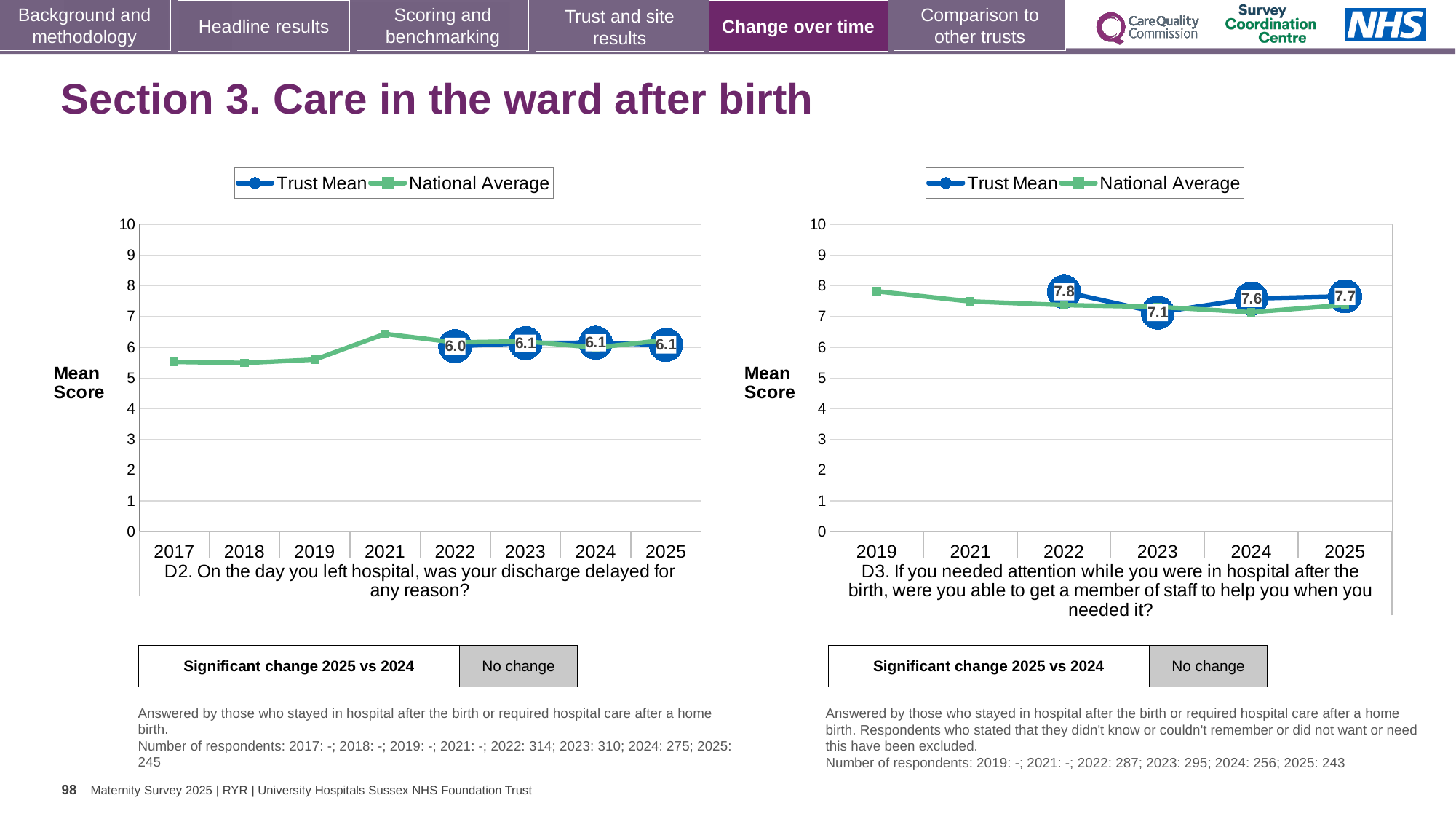
How many series does the legend of the D3 chart on the right list? 2 In the D3 chart on the right, which year has the lowest Trust Mean score? 2023 In the D2 chart on the left, what is the Trust Mean score for 2022? 6.0 In the D2 chart on the left, is the National Average for 2017 greater or less than 6? less What kind of chart is the D2 chart on the left? Line chart How many years are shown on the x axis of the D2 chart on the left? 8 In the D3 chart on the right, is the National Average for 2019 greater or less than 7? greater In the D3 chart on the right, which is larger: the Trust Mean for 2024 or the Trust Mean for 2025? 2025 In the D3 chart on the right, what is the difference between the Trust Mean scores for 2022 and 2023? 0.7 In the D3 chart on the right, what is the Trust Mean score for 2023? 7.1 In the D3 chart on the right, which year has the highest Trust Mean score? 2022 In the D2 chart on the left, what is the Trust Mean score for 2025? 6.1